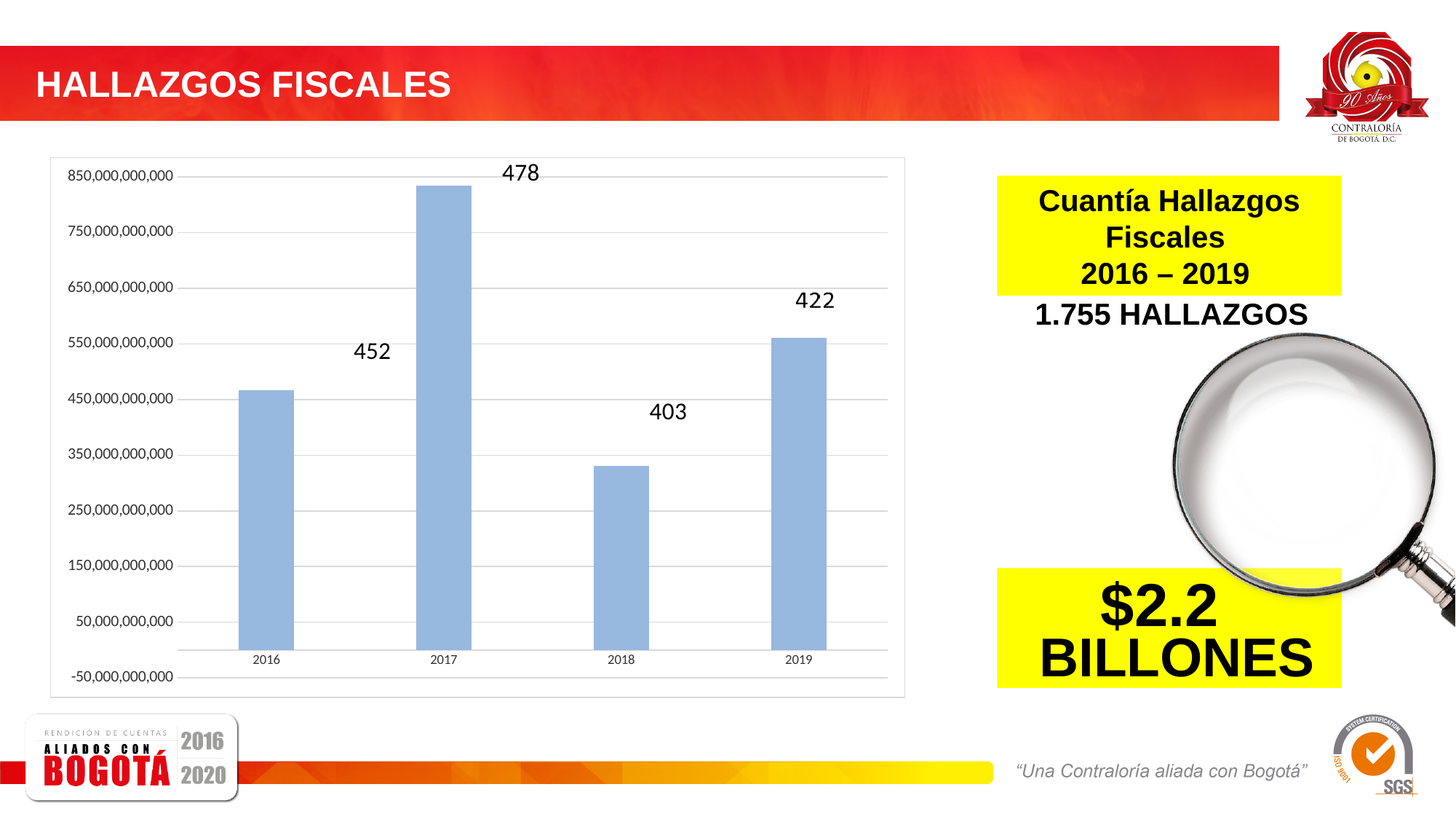
What is the data label printed above the bar for 2017? 478 Does the bar height rise or fall from 2017 to 2018? fall Is the bar for 2017 greater or less than 750,000,000,000? greater Which year has the shortest bar in the chart? 2018 What is the difference between the data labels for 2017 and 2016? 26 Is the bar for 2018 greater or less than 450,000,000,000? less How many years (categories) are shown on the x axis of the chart? 4 What kind of chart is shown on the slide? Bar chart Which bar is taller, 2019 or 2016? 2019 Which year has the tallest bar in the chart? 2017 What is the data label printed above the bar for 2016? 452 What is the data label printed above the bar for 2018? 403